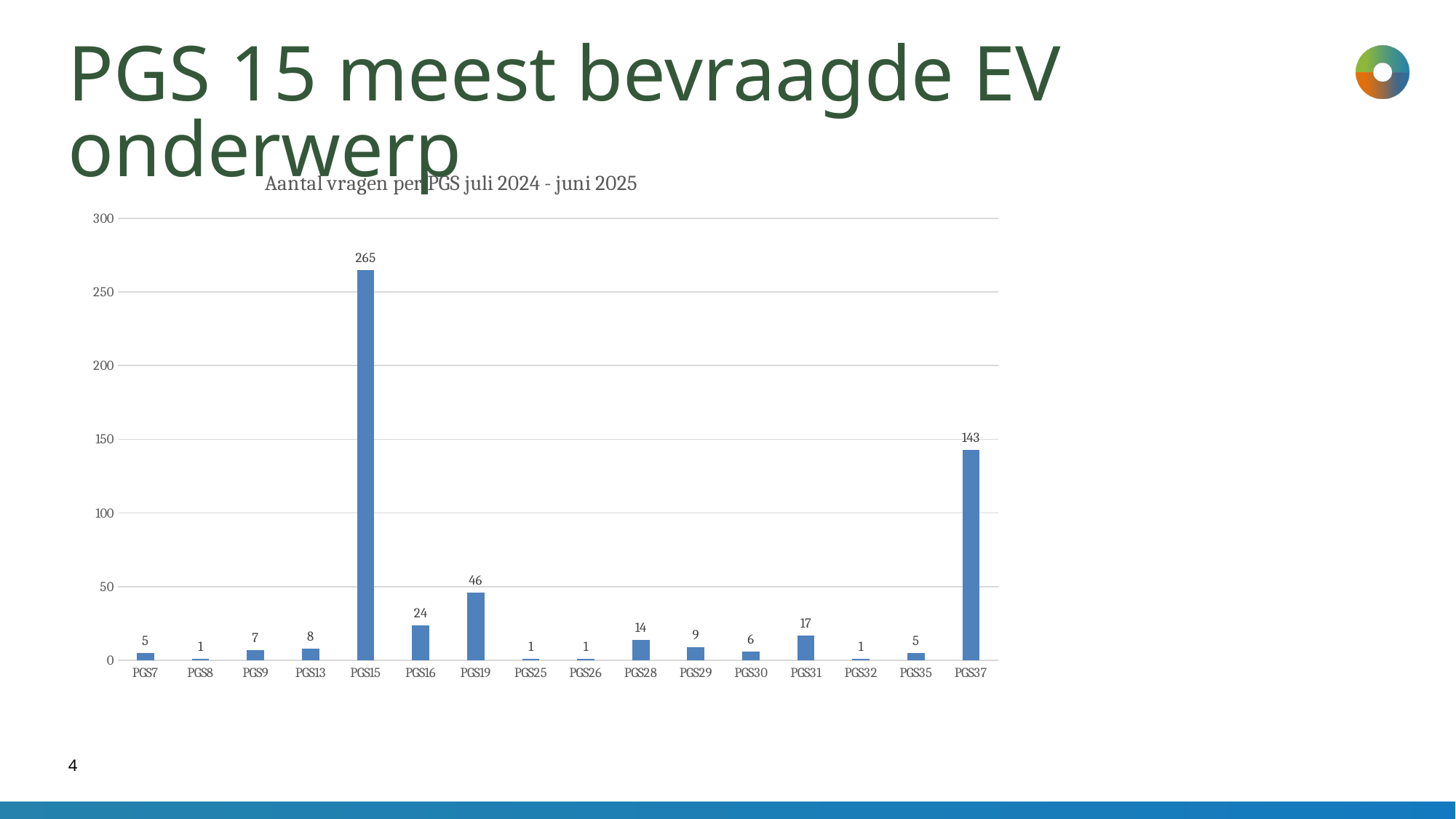
What is the value for PGS19? 46 What is the value for PGS37? 143 Which PGS has the highest number of questions? PGS15 Is the value for PGS37 greater or less than 100? greater What is the title of the chart? Aantal vragen per PGS juli 2024 - juni 2025 How many PGS categories are shown on the x axis? 16 What kind of chart is shown on the slide? bar chart Which has a larger value, PGS28 or PGS29? PGS28 What is the value for PGS15? 265 What is the value for PGS31? 17 What is the difference between the values for PGS15 and PGS37? 122 What is the difference between the values for PGS19 and PGS16? 22